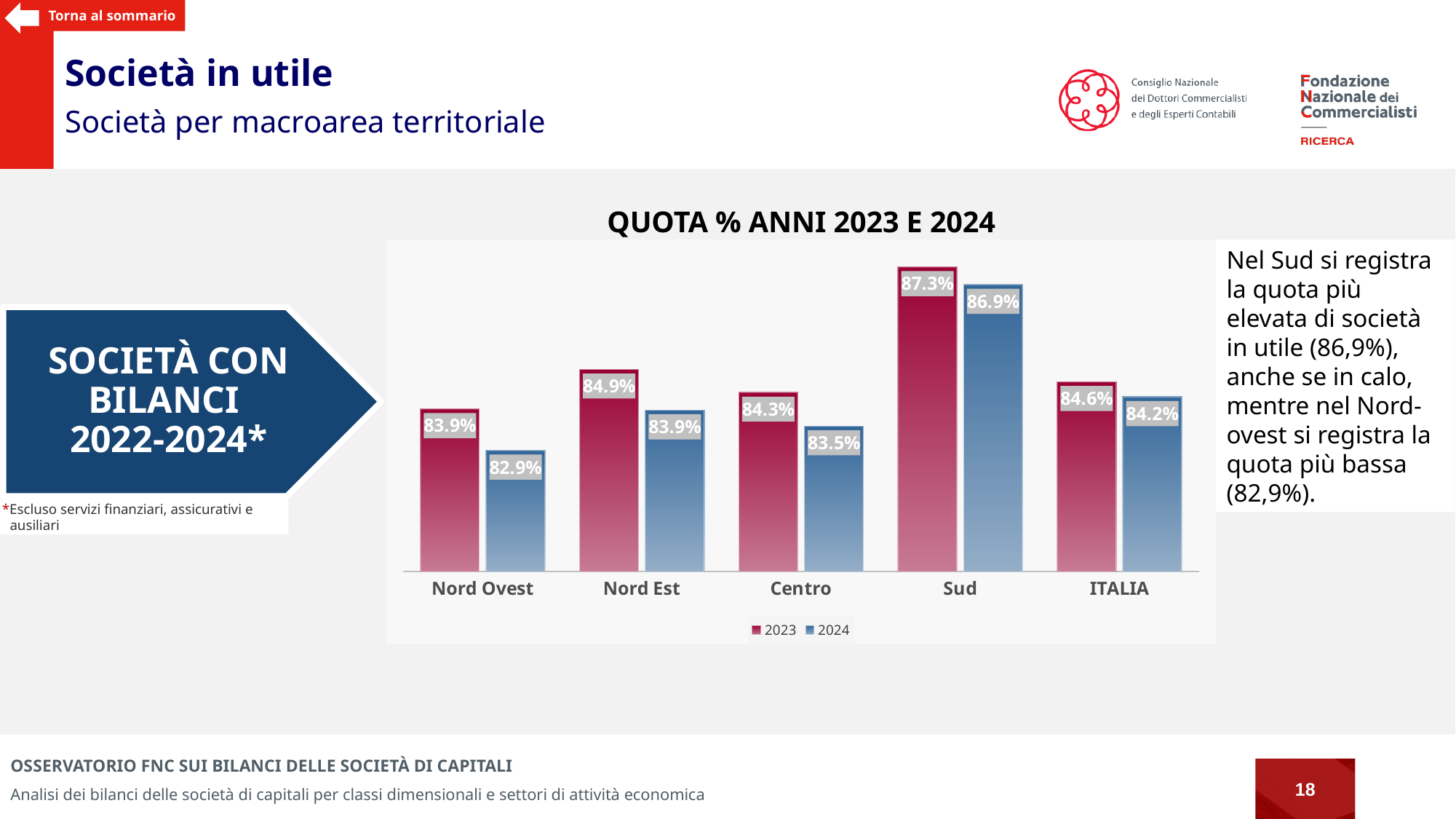
Which category has the lowest 2023 value? Nord Ovest What is the title of the chart? QUOTA % ANNI 2023 E 2024 What kind of chart is shown? Bar chart What is the 2023 value for Centro? 84.3% What is the 2024 value for Nord Ovest? 82.9% How many categories are shown on the x axis? 5 Which is larger for Centro, the 2023 value or the 2024 value? 2023 What is the 2024 value for ITALIA? 84.2% How many series does the legend list? 2 What is the difference between the 2023 and 2024 values for Nord Est? 1.0% Which category has the highest 2024 value? Sud What is the 2023 value for Sud? 87.3%